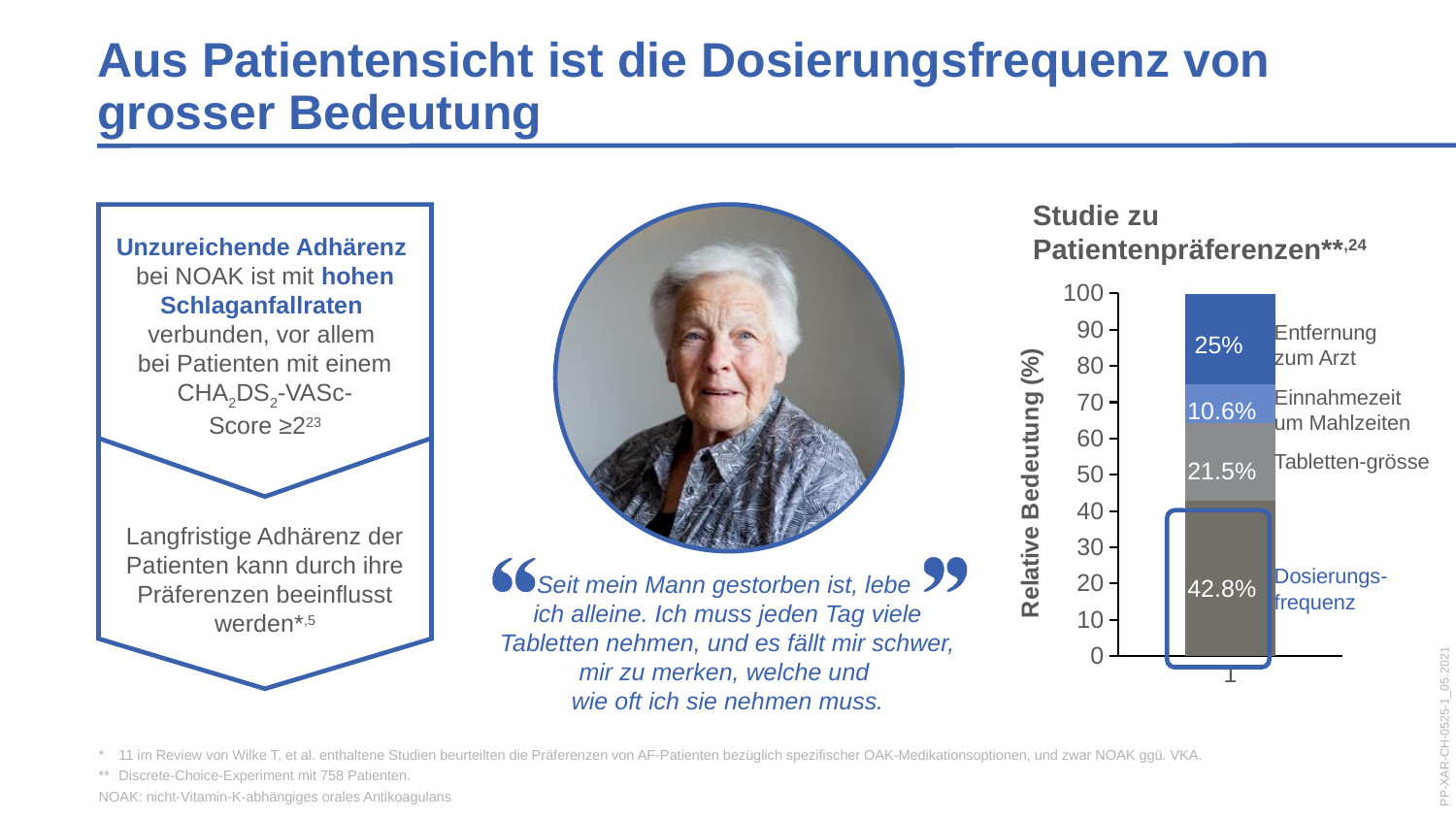
What value is shown for Dosierungsfrequenz in the stacked bar chart? 42.8% Which segment of the stacked bar has the highest value? Dosierungsfrequenz What value is shown for Entfernung zum Arzt in the chart? 25% What value is shown for Einnahmezeit um Mahlzeiten in the chart? 10.6% What value is shown for Tabletten-grösse in the chart? 21.5% What kind of chart is shown on the slide? Stacked bar chart Which segment of the stacked bar has the lowest value? Einnahmezeit um Mahlzeiten Which is larger, the value for Entfernung zum Arzt or the value for Tabletten-grösse? Entfernung zum Arzt What is the label of the vertical axis of the chart? Relative Bedeutung (%) How many segments make up the stacked bar in the chart? 4 What is the difference between the values for Dosierungsfrequenz and Tabletten-grösse? 21.3% What is the difference between the values for Entfernung zum Arzt and Einnahmezeit um Mahlzeiten? 14.4%